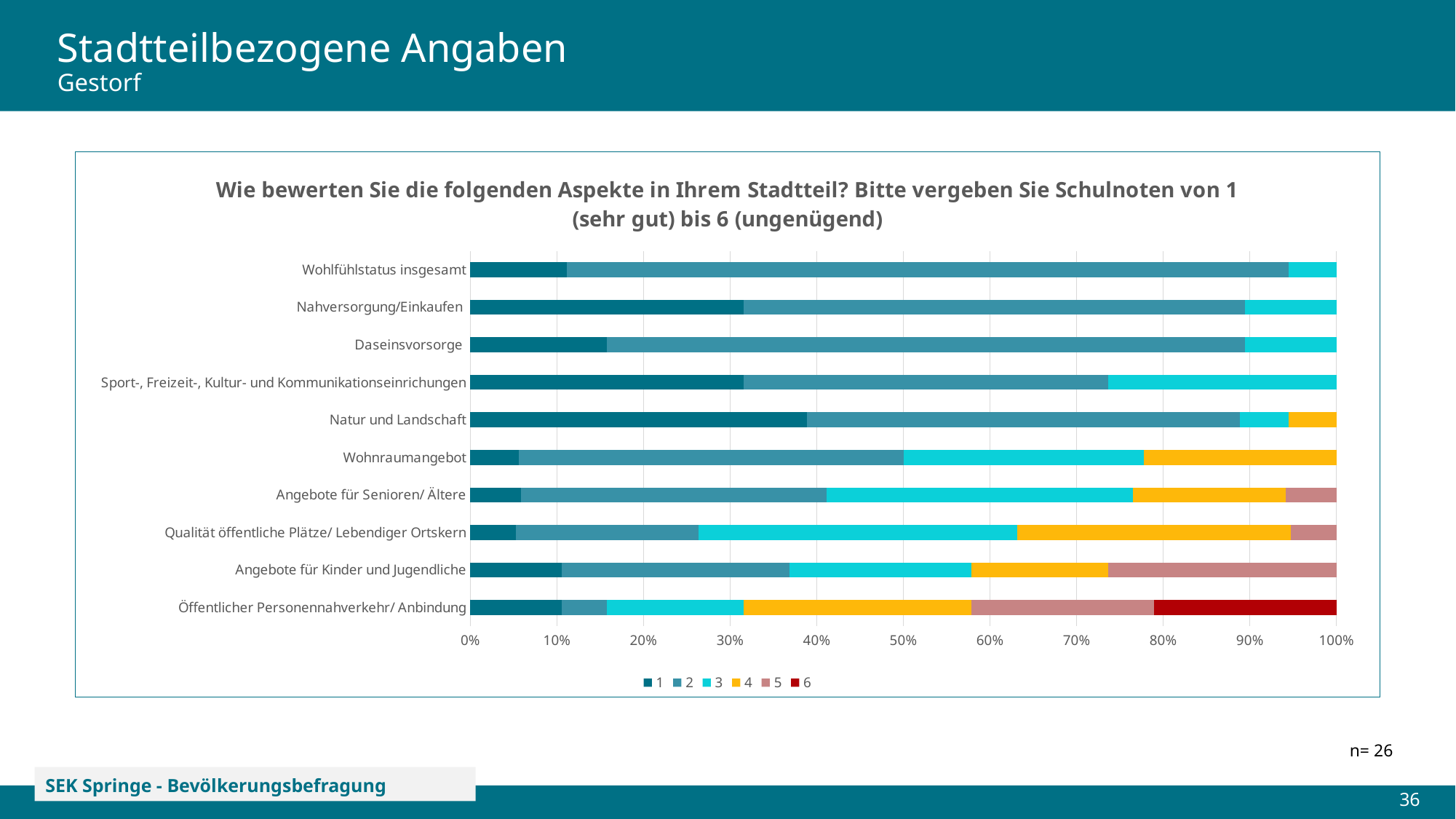
Is the share of grade 1 for 'Wohlfühlstatus insgesamt' greater or less than 20%? less Is the share of grade 6 for 'Öffentlicher Personennahverkehr/ Anbindung' greater or less than 10%? greater Is the share of grade 1 for 'Wohnraumangebot' greater or less than 10%? less Which category is listed at the top of the chart? Wohlfühlstatus insgesamt What are the legend entries of the chart? 1, 2, 3, 4, 5, 6 Which has the larger share of grade 1: 'Natur und Landschaft' or 'Wohnraumangebot'? Natur und Landschaft Which category is the only one with a grade 6 segment? Öffentlicher Personennahverkehr/ Anbindung How many categories (aspects) are listed on the vertical axis of the chart? 10 What kind of chart is shown on the slide? Stacked bar chart Which category has the largest share of grade 1? Natur und Landschaft How many series does the chart legend list? 6